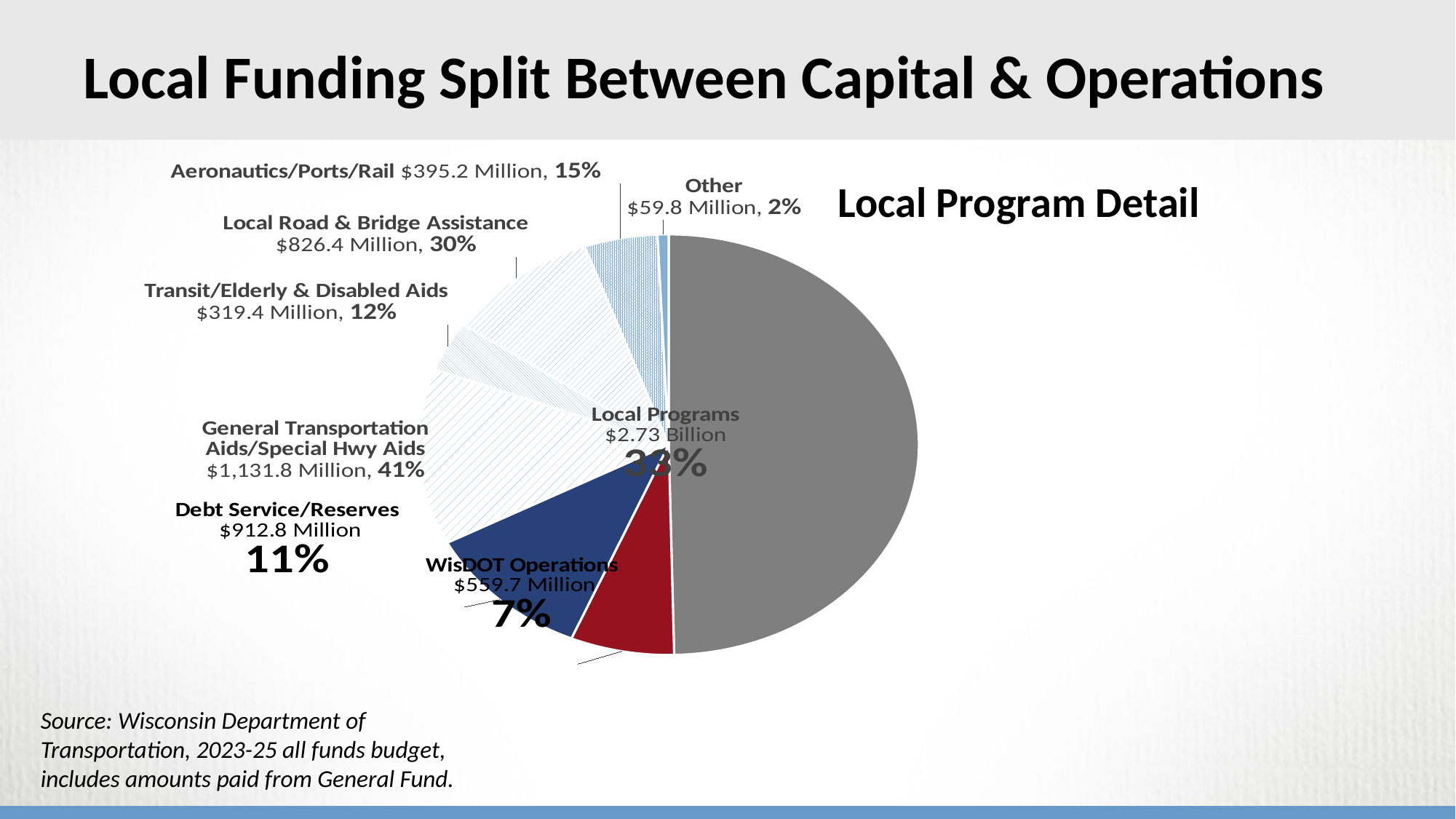
What dollar amount is shown for WisDOT Operations? $559.7 Million What percentage is shown for Local Road & Bridge Assistance? 30% What dollar amount is shown for Local Programs? $2.73 Billion What dollar amount is shown for Transit/Elderly & Disabled Aids? $319.4 Million What dollar amount is shown for Debt Service/Reserves? $912.8 Million What title is printed to the right of the pie chart? Local Program Detail What type of chart is shown on the slide? Pie chart What is the difference in dollar amount between Local Road & Bridge Assistance and Aeronautics/Ports/Rail? $431.2 Million What dollar amount is shown for the Other category? $59.8 Million Which has the larger dollar amount, Debt Service/Reserves or WisDOT Operations? Debt Service/Reserves What percentage is shown for General Transportation Aids/Special Hwy Aids? 41% What dollar amount is shown for Aeronautics/Ports/Rail? $395.2 Million